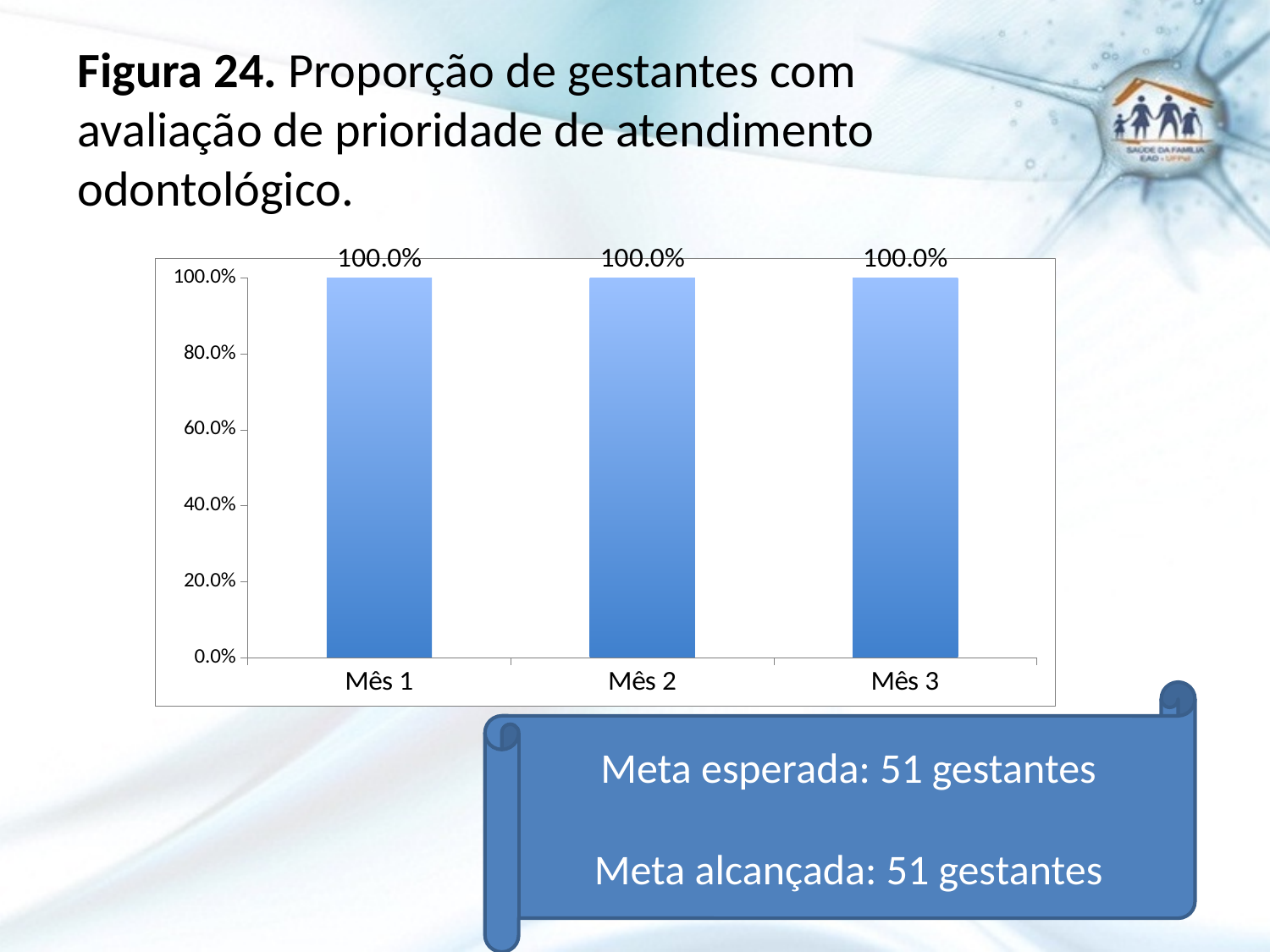
How many categories are shown on the x axis? 3 Is the value for Mês 2 greater or less than 80.0%? greater What is the highest value shown on the y axis? 100.0% What is the value for Mês 1? 100.0% What is the difference between the values for Mês 1 and Mês 3? 0.0% Do the values rise, fall or stay the same from Mês 1 to Mês 3? stay the same What is the figure number given in the slide title? Figura 24 What kind of chart is shown on the slide? bar chart What is the value for Mês 2? 100.0% What is the value for Mês 3? 100.0%